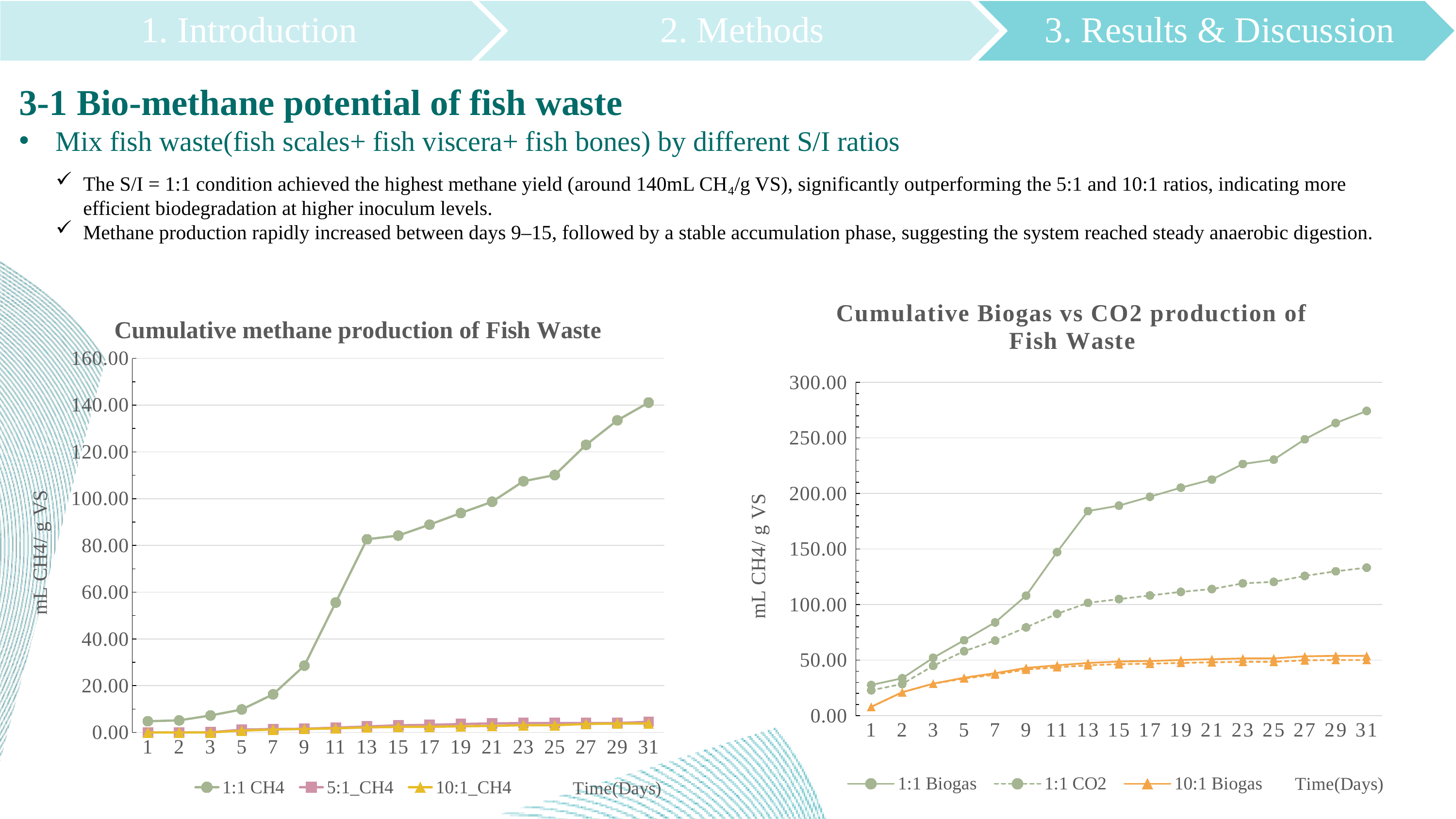
What type of chart is the 'Cumulative methane production of Fish Waste' chart? line chart In the 'Cumulative Biogas vs CO2 production of Fish Waste' chart, which is larger at day 31: 1:1 Biogas or 10:1 Biogas? 1:1 Biogas In the 'Cumulative methane production of Fish Waste' chart, which series has the highest value at day 31? 1:1 CH4 In the 'Cumulative Biogas vs CO2 production of Fish Waste' chart, is the value for 1:1 Biogas at day 31 greater or less than 250? greater What is the x-axis label of the 'Cumulative Biogas vs CO2 production of Fish Waste' chart? Time(Days) In the 'Cumulative methane production of Fish Waste' chart, does the 1:1 CH4 series rise or fall from day 1 to day 31? rise In the 'Cumulative methane production of Fish Waste' chart, is the value for 1:1 CH4 at day 31 greater or less than 120? greater In the 'Cumulative Biogas vs CO2 production of Fish Waste' chart, is the value for 1:1 CO2 at day 31 greater or less than 100? greater How many time points are plotted along the x axis of the 'Cumulative methane production of Fish Waste' chart? 17 How many series does the legend of the 'Cumulative Biogas vs CO2 production of Fish Waste' chart list? 3 How many series does the legend of the 'Cumulative methane production of Fish Waste' chart list? 3